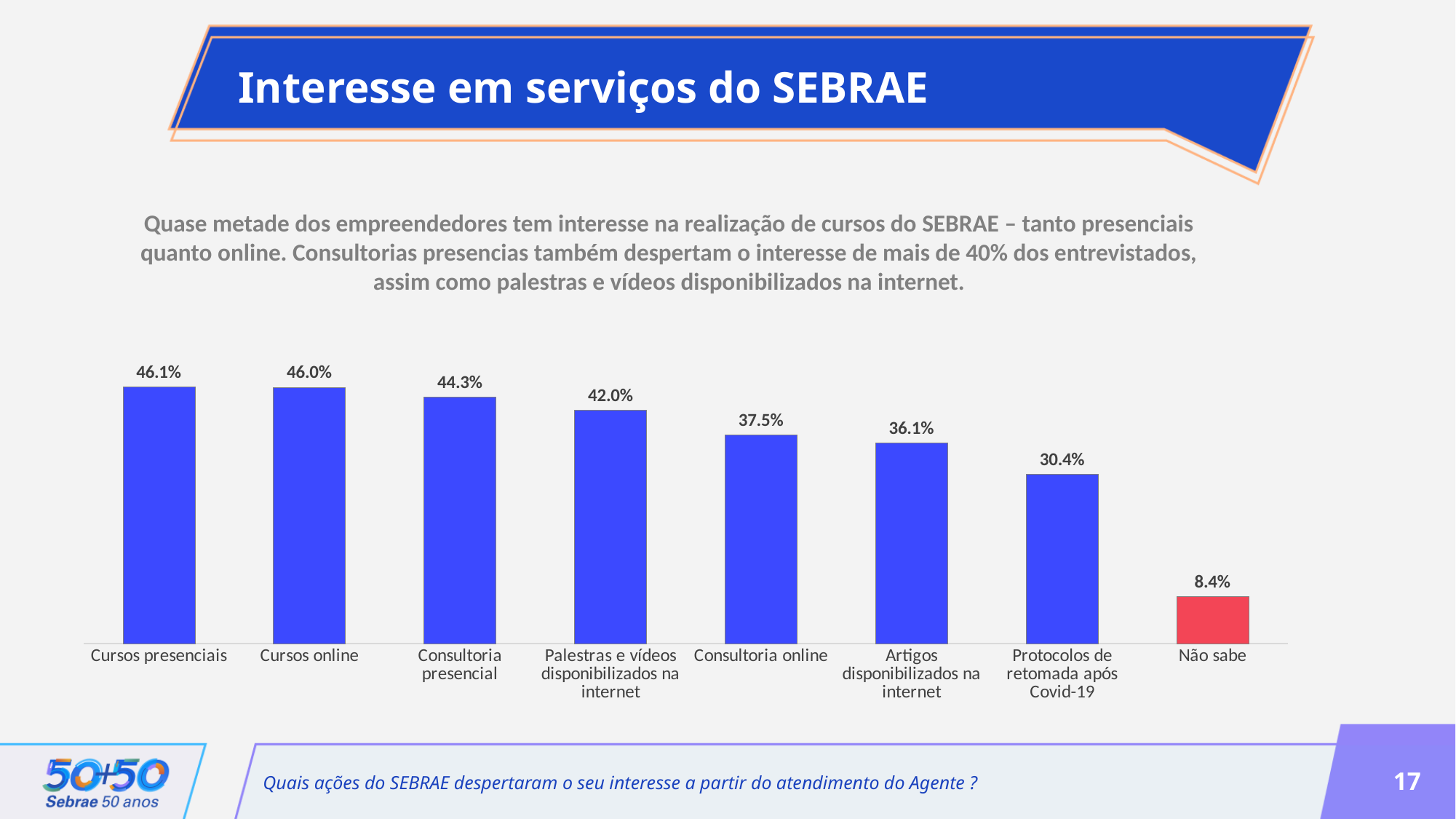
What kind of chart is shown on the slide? Bar chart What is the difference between Consultoria presencial and Consultoria online? 6.8% What is the value for Consultoria online? 37.5% How many categories are shown in the chart? 8 Which is larger, Artigos disponibilizados na internet or Protocolos de retomada após Covid-19? Artigos disponibilizados na internet Which bar is shown in a different colour (red) from the others? Não sabe Which category has the highest value? Cursos presenciais Which category has the lowest value? Não sabe What is the value for Cursos presenciais? 46.1% What is the difference between Palestras e vídeos disponibilizados na internet and Não sabe? 33.6% Do the values rise or fall from left to right along the x axis? Fall What is the value for Protocolos de retomada após Covid-19? 30.4%